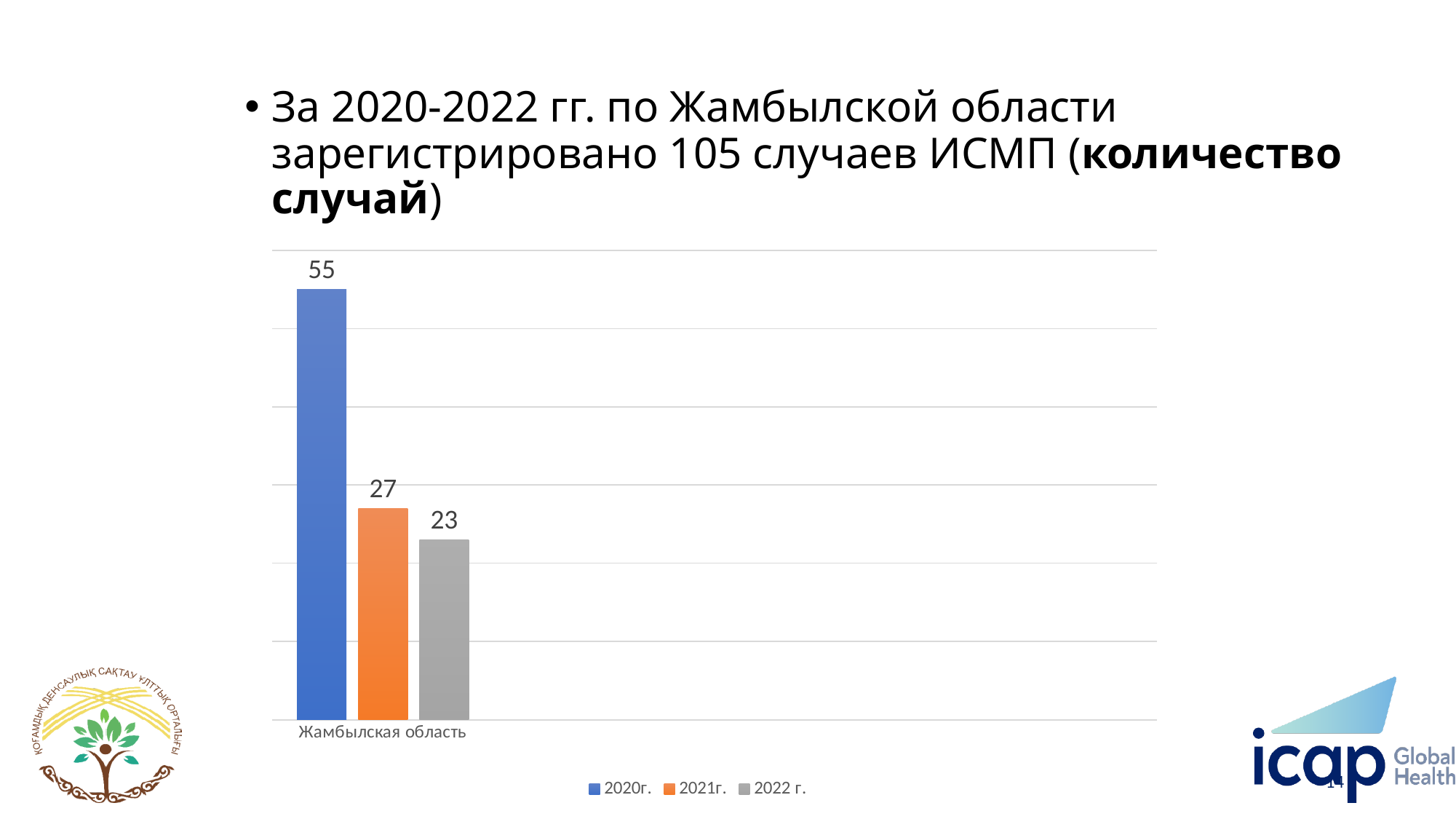
Which year has the highest value in the chart? 2020г. What is the value for 2021г. in the chart? 27 Which is larger, the value for 2020г. or the value for 2022 г.? 2020г. What is the category label shown on the x axis of the chart? Жамбылская область What is the difference between the values for 2020г. and 2021г.? 28 What kind of chart is shown on the slide? bar chart What is the value for 2022 г. in the chart? 23 What is the value for 2020г. in the chart? 55 Which year has the lowest value in the chart? 2022 г. Do the values rise or fall from 2020г. to 2022 г.? fall What is the difference between the values for 2021г. and 2022 г.? 4 How many series does the legend list? 3